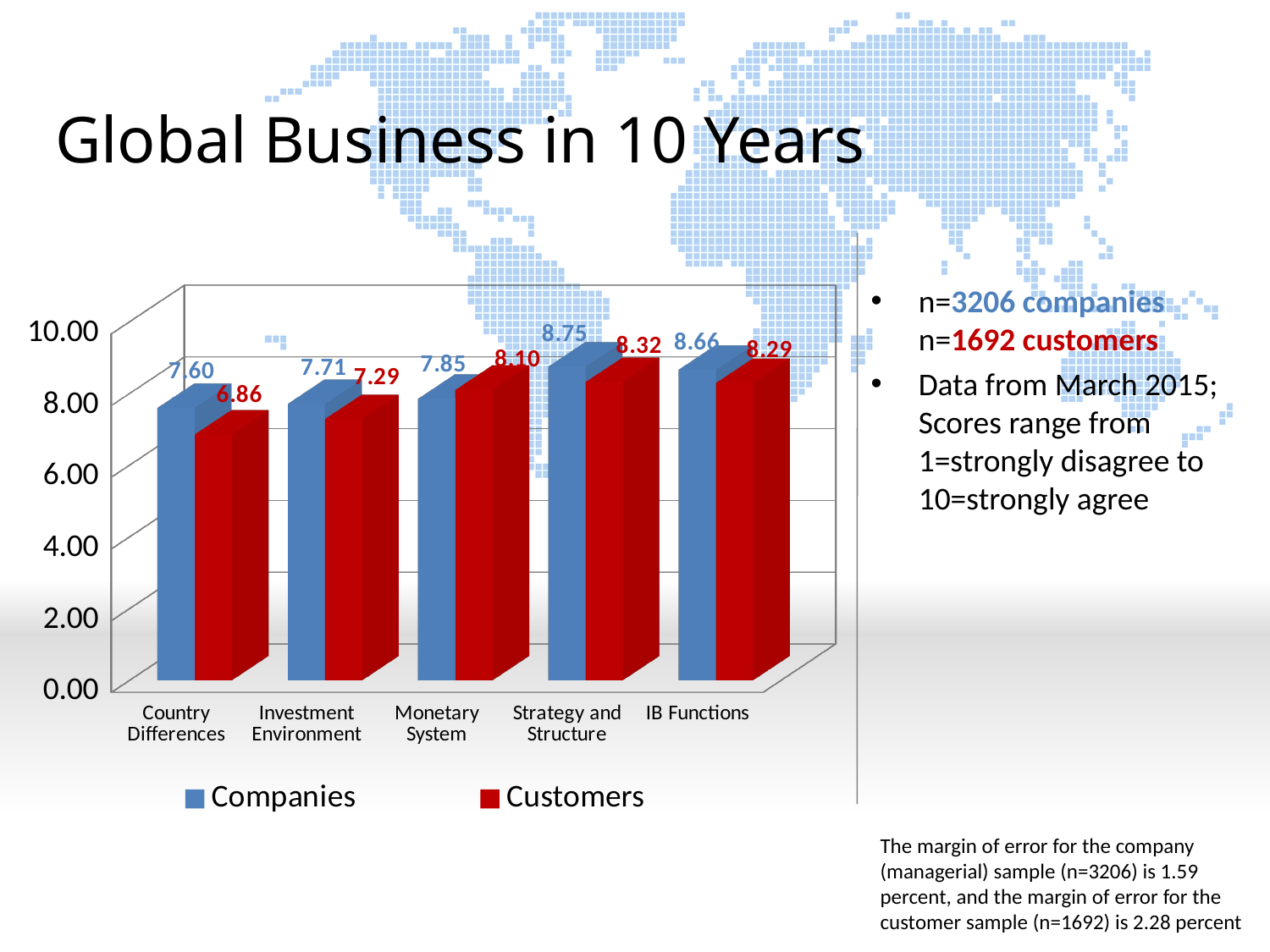
What is the Customers value for Monetary System? 8.10 Which category has the lowest Customers value? Country Differences What is the difference between the Companies and Customers values for Country Differences? 0.74 How many categories are shown on the x axis? 5 Is the Customers value for Investment Environment greater or less than 8.00? less Which is larger for Monetary System, the Companies value or the Customers value? Customers What colour are the Customers bars? red What kind of chart is shown on the slide? bar chart What is the Customers value for IB Functions? 8.29 What is the Companies value for Country Differences? 7.60 Which category has the highest Companies value? Strategy and Structure How many series does the legend list? 2